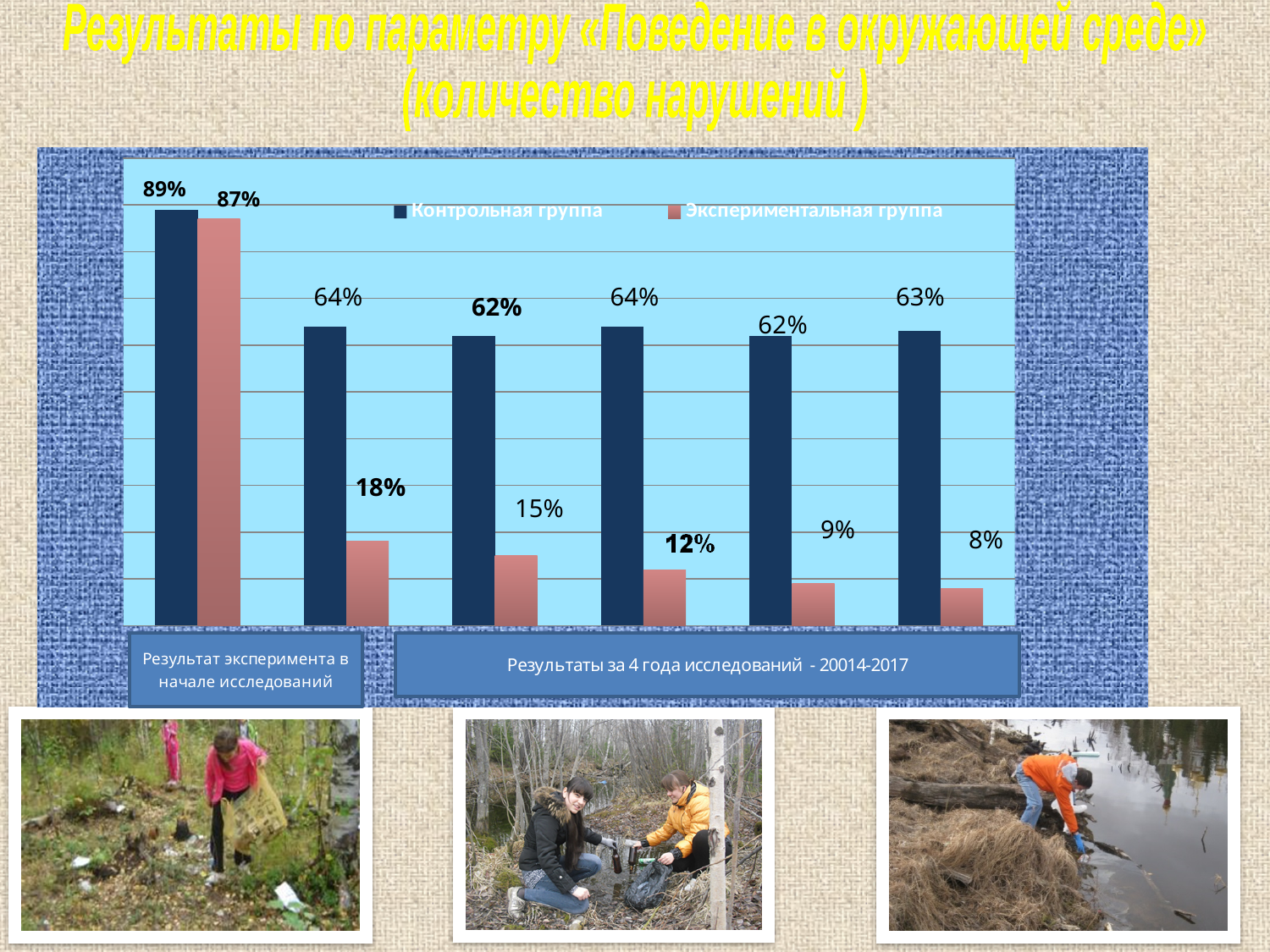
What kind of chart is shown on the slide? bar chart What is the value for Экспериментальная группа in the first (leftmost) group of bars? 87% In the second group of bars from the left, which series has the larger value? Контрольная группа What is the value for Экспериментальная группа in the last (rightmost) group of bars? 8% How many groups of bars are plotted in the chart? 6 How many series does the chart legend list? 2 What colour are the bars for Контрольная группа? dark blue What is the value for Контрольная группа in the first (leftmost) group of bars? 89% In which group of bars is the Экспериментальная группа value highest? the first (leftmost) group Do the Экспериментальная группа values rise or fall from left to right across the chart? fall In the rightmost group of bars, what is the difference between the Контрольная группа value and the Экспериментальная группа value? 55% In which group of bars is the Экспериментальная группа value lowest? the last (rightmost) group